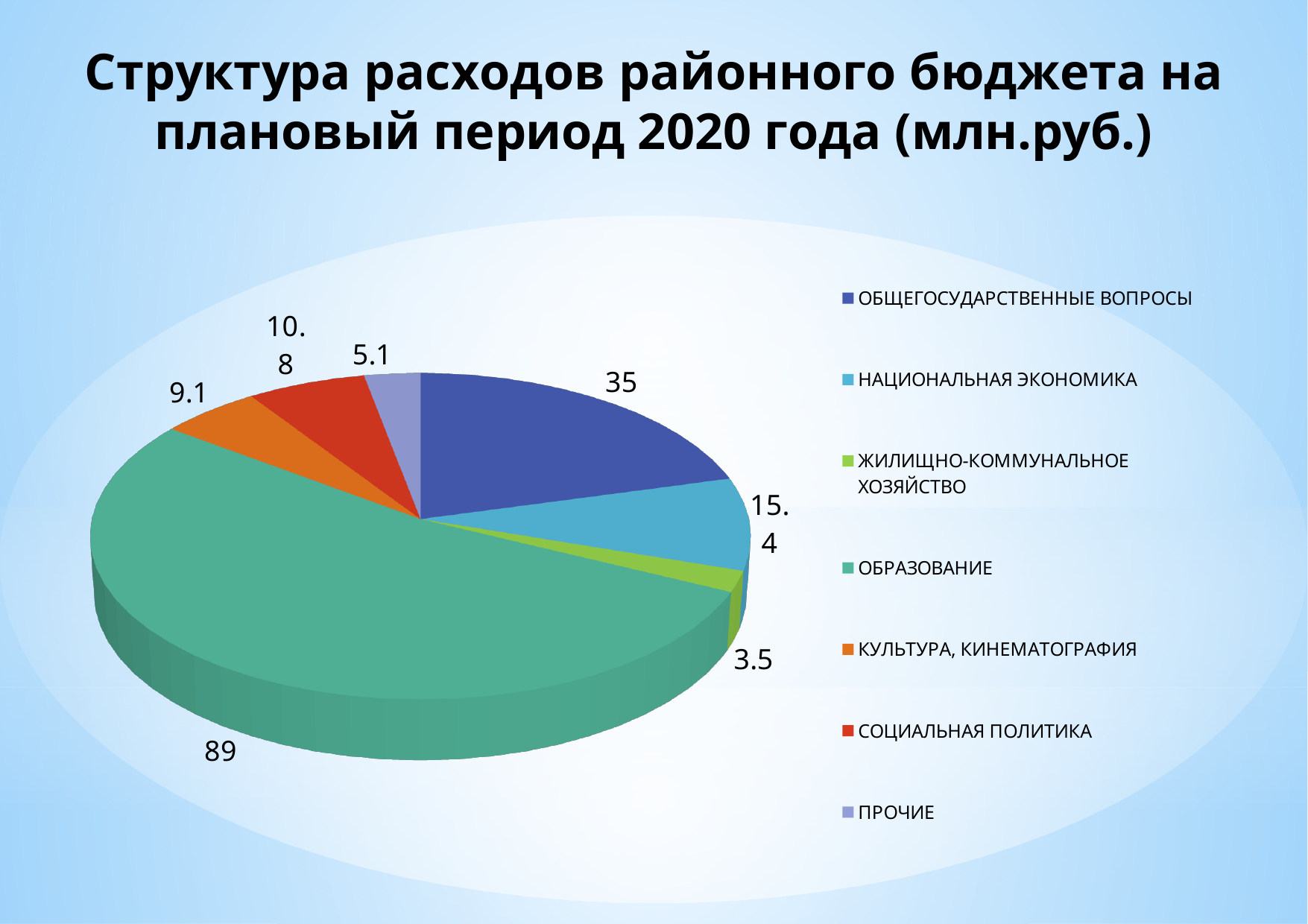
Which is larger, the value for СОЦИАЛЬНАЯ ПОЛИТИКА or the value for КУЛЬТУРА, КИНЕМАТОГРАФИЯ? СОЦИАЛЬНАЯ ПОЛИТИКА What is the difference between the values for ОБРАЗОВАНИЕ and ОБЩЕГОСУДАРСТВЕННЫЕ ВОПРОСЫ? 54 What is the value for ОБРАЗОВАНИЕ? 89 Which category has the smallest slice? ЖИЛИЩНО-КОММУНАЛЬНОЕ ХОЗЯЙСТВО What is the value for НАЦИОНАЛЬНАЯ ЭКОНОМИКА? 15.4 What is the value for ПРОЧИЕ? 5.1 How many categories does the pie chart show? 7 What is the value for ОБЩЕГОСУДАРСТВЕННЫЕ ВОПРОСЫ? 35 Which category has the largest slice? ОБРАЗОВАНИЕ What kind of chart is shown on the slide? Pie chart What colour is the slice for ОБРАЗОВАНИЕ? Green What is the value for СОЦИАЛЬНАЯ ПОЛИТИКА? 10.8